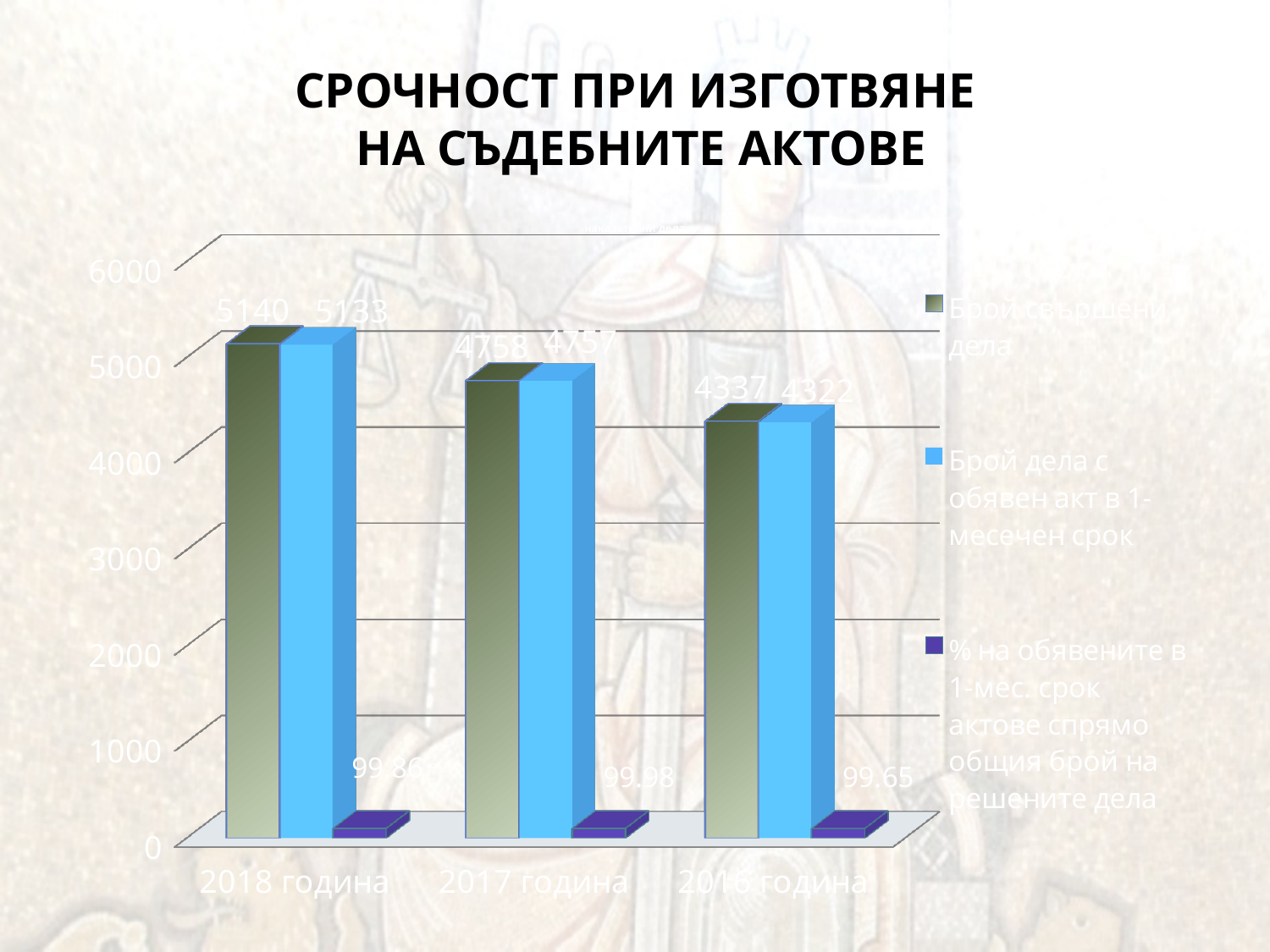
What is the difference in "Брой свършени дела" between 2018 година and 2017 година? 382 Which year has the highest value of "Брой свършени дела"? 2018 година What is the difference between "Брой свършени дела" and "Брой дела с обявен акт в 1-месечен срок" for 2016 година? 15 What kind of chart is shown on the slide? bar chart What is the value of "Брой свършени дела" for 2016 година? 4337 Which year has the lowest value of "Брой дела с обявен акт в 1-месечен срок"? 2016 година Is the value of "Брой свършени дела" for 2017 година greater or less than 5000? less How many year categories are shown on the x axis? 3 What is the value of "Брой свършени дела" for 2018 година? 5140 How many series does the legend list? 3 What is the percentage value ("% на обявените в 1-мес. срок актове спрямо общия брой на решените дела") for 2017 година? 99.98 What is the value of "Брой дела с обявен акт в 1-месечен срок" for 2017 година? 4757